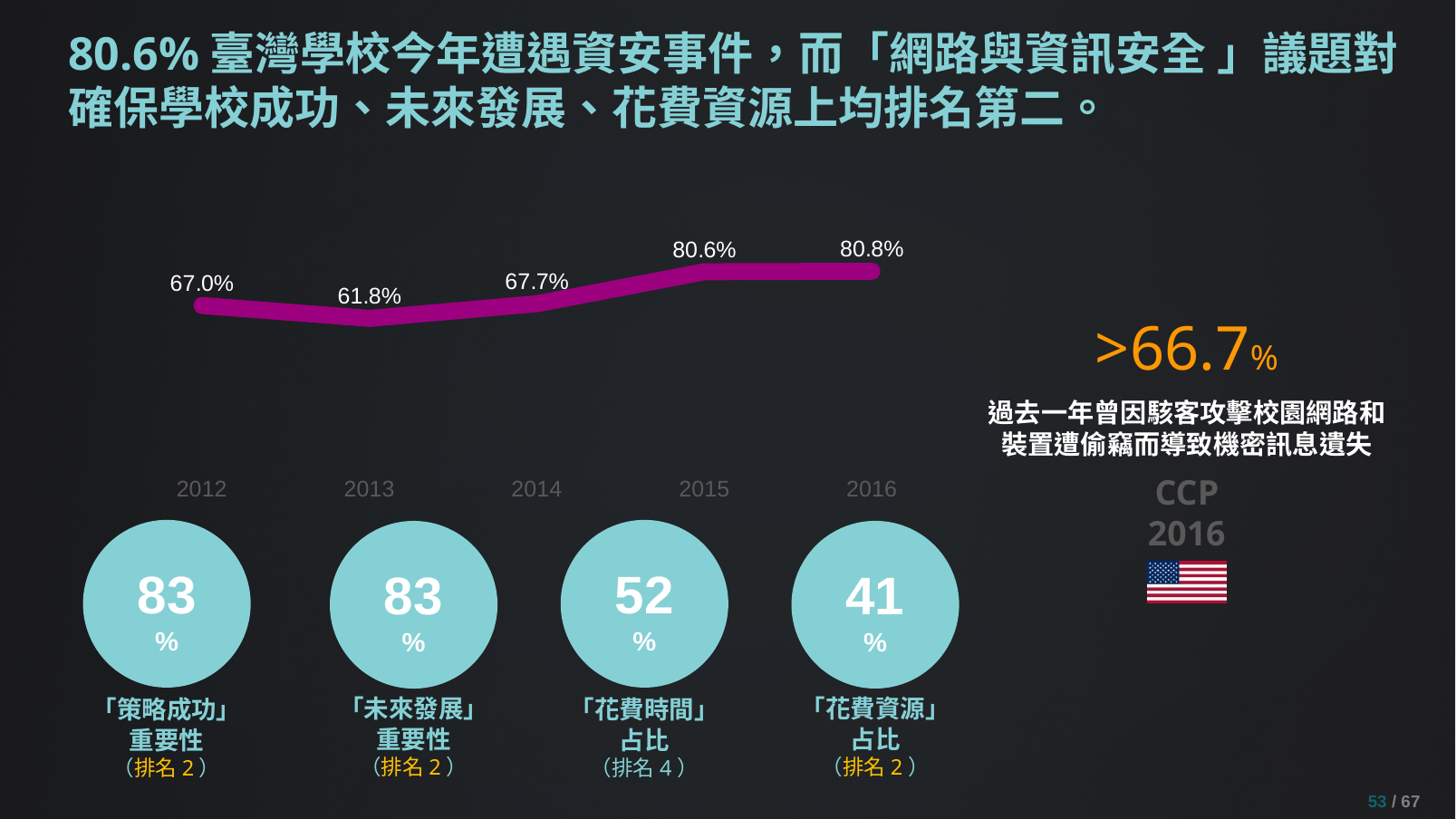
What kind of chart is shown on the slide? line chart Which is larger in the line chart, the value for 2012 or the value for 2014? 2014 What is the difference between the 2015 and 2014 values in the line chart? 12.9% Which year has the highest value in the line chart? 2016 Does the value in the line chart rise or fall from 2013 to 2016? rise How many years are plotted in the line chart? 5 Which year has the lowest value in the line chart? 2013 What is the value for 2016 in the line chart? 80.8% What colour is the line in the line chart? purple What is the value for 2013 in the line chart? 61.8% What is the value for 2012 in the line chart? 67.0% What is the value for 2015 in the line chart? 80.6%